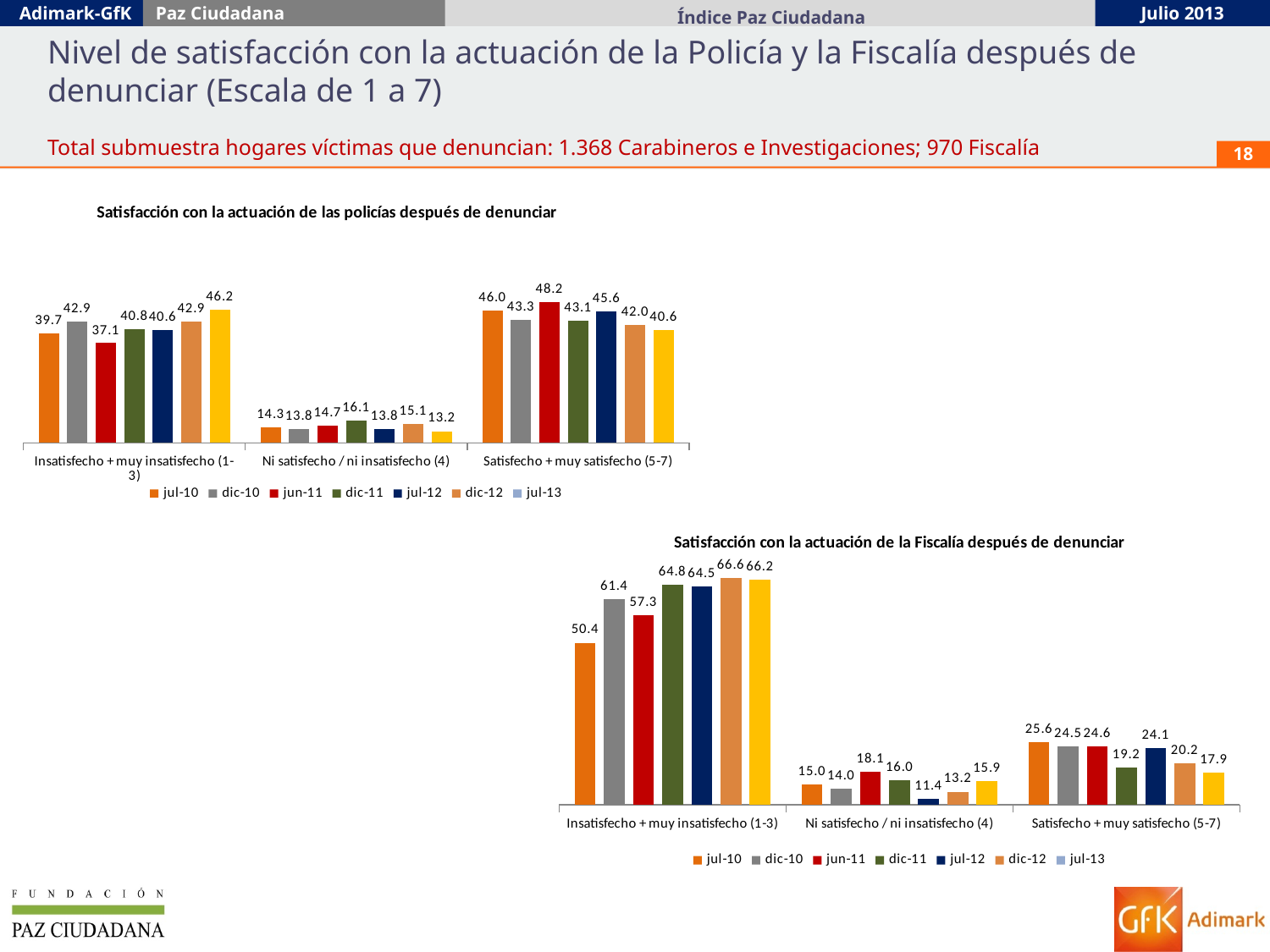
How many series does the legend list in the chart 'Satisfacción con la actuación de las policías después de denunciar'? 7 In the chart 'Satisfacción con la actuación de la Fiscalía después de denunciar', which is larger in the 'Satisfecho + muy satisfecho (5-7)' category: jul-10 or dic-11? jul-10 What kind of chart is 'Satisfacción con la actuación de la Fiscalía después de denunciar'? Bar chart In the chart 'Satisfacción con la actuación de la Fiscalía después de denunciar', what is the value for jul-10 in the 'Insatisfecho + muy insatisfecho (1-3)' category? 50.4 In the chart 'Satisfacción con la actuación de la Fiscalía después de denunciar', which series has the highest value in the 'Insatisfecho + muy insatisfecho (1-3)' category? dic-12 In the chart 'Satisfacción con la actuación de la Fiscalía después de denunciar', what is the difference between the jul-13 and jul-10 values in the 'Satisfecho + muy satisfecho (5-7)' category? 7.7 In the chart 'Satisfacción con la actuación de las policías después de denunciar', what is the value for jul-13 in the 'Insatisfecho + muy insatisfecho (1-3)' category? 46.2 In the chart 'Satisfacción con la actuación de las policías después de denunciar', what is the value for jun-11 in the 'Satisfecho + muy satisfecho (5-7)' category? 48.2 In the chart 'Satisfacción con la actuación de las policías después de denunciar', what is the difference between the jul-13 and jul-10 values in the 'Insatisfecho + muy insatisfecho (1-3)' category? 6.5 How many categories are shown on the x axis of the chart 'Satisfacción con la actuación de la Fiscalía después de denunciar'? 3 In the chart 'Satisfacción con la actuación de la Fiscalía después de denunciar', what is the value for jul-12 in the 'Ni satisfecho / ni insatisfecho (4)' category? 11.4 In the chart 'Satisfacción con la actuación de las policías después de denunciar', which series has the lowest value in the 'Satisfecho + muy satisfecho (5-7)' category? jul-13